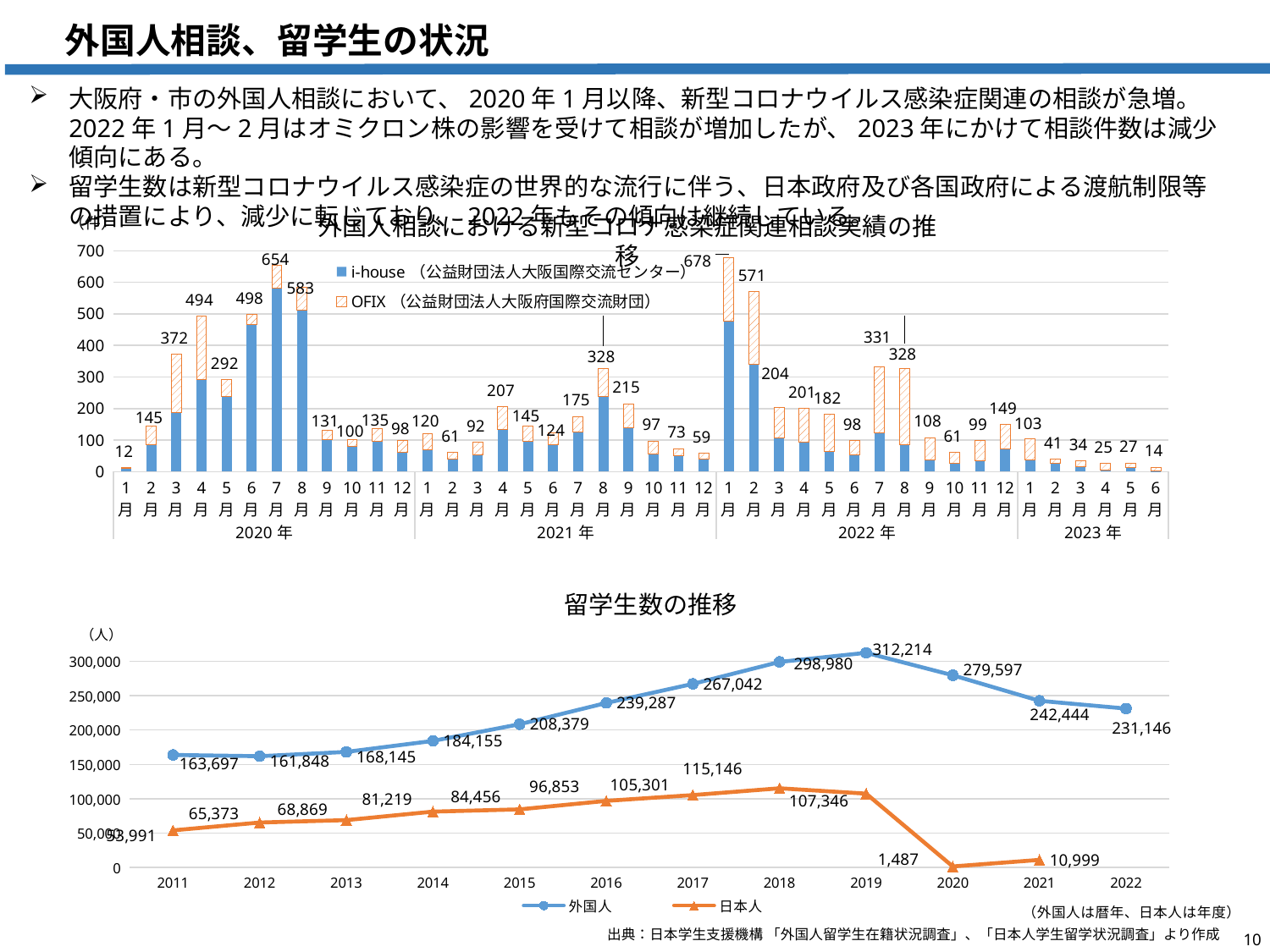
In the top chart (外国人相談における新型コロナ感染症関連相談実績の推移), which is larger, the total for 2020年3月 or the total for 2021年8月? 2020年3月 In the bottom chart (留学生数の推移), what is the difference between the 外国人 values for 2019 and 2022? 81,068 In the top chart (外国人相談における新型コロナ感染症関連相談実績の推移), what is the difference between the totals for 2022年1月 and 2022年2月? 107 In the top chart (外国人相談における新型コロナ感染症関連相談実績の推移), which month has the highest total number of consultations? 2022年1月 In the top chart (外国人相談における新型コロナ感染症関連相談実績の推移), what is the total number of consultations in 2020年7月? 654 In the top chart (外国人相談における新型コロナ感染症関連相談実績の推移), how many series does the legend list? 2 In the top chart (外国人相談における新型コロナ感染症関連相談実績の推移), which month has the lowest total number of consultations? 2020年1月 What kind of chart is the bottom chart titled 留学生数の推移? line chart In the bottom chart (留学生数の推移), does the 外国人 line rise or fall from 2011 to 2019? rise In the bottom chart (留学生数の推移), what is the 日本人 value for 2020? 1,487 In the bottom chart (留学生数の推移), in which year is the 外国人 value highest? 2019 What kind of chart is the top chart titled 外国人相談における新型コロナ感染症関連相談実績の推移? bar chart